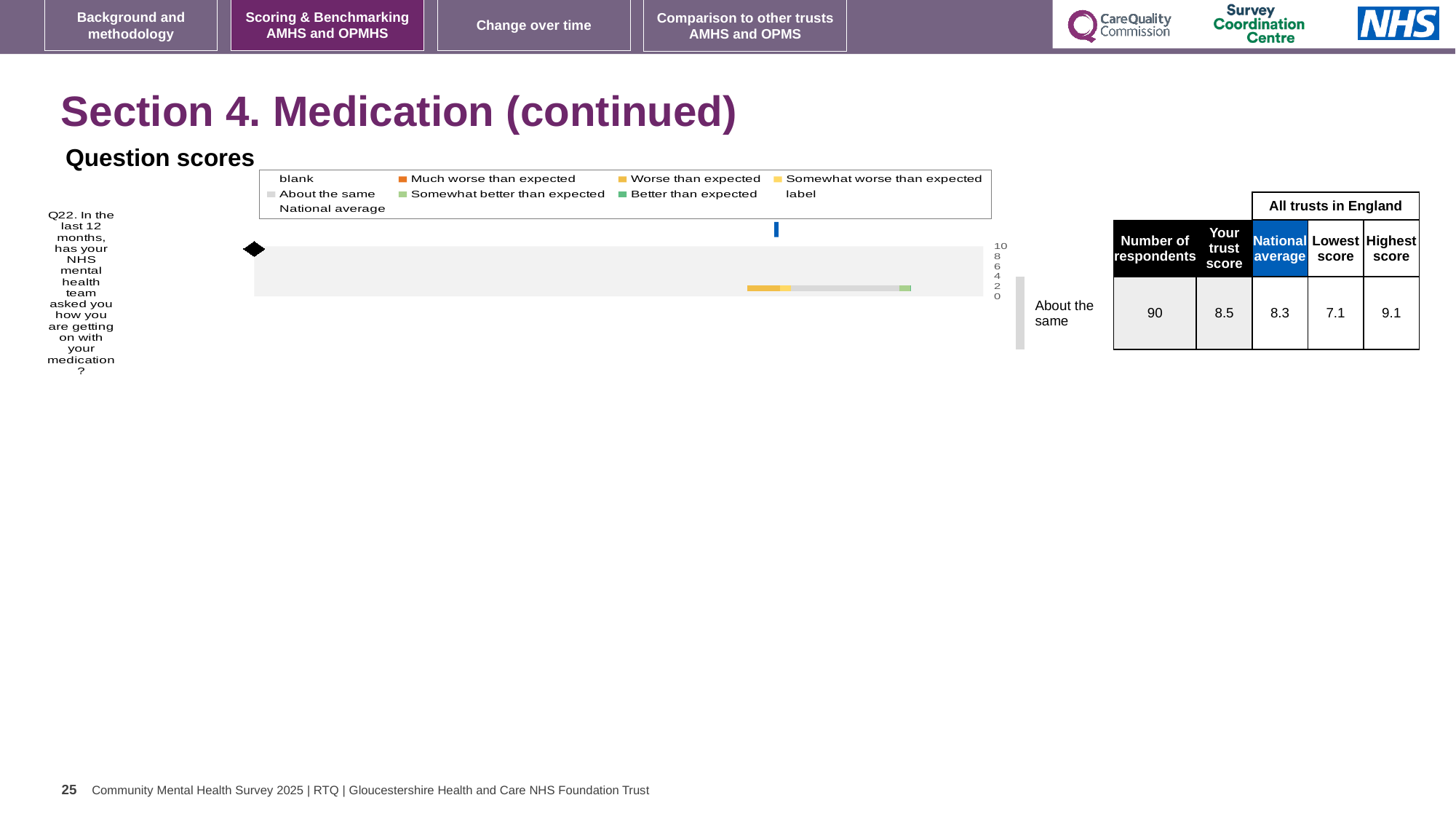
What is the highest value shown on the axis of the Question scores chart? 10 What is the difference between the highest and lowest trust scores for Q22? 2.0 What is the trust's score for Q22 shown next to the chart? 8.5 How is the trust's Q22 result categorised relative to expectation? About the same How many respondents answered Q22? 90 What is the highest score among all trusts in England for Q22? 9.1 Is the trust's score for Q22 higher or lower than the national average? higher What kind of chart is shown under 'Question scores'? bar chart What is the lowest score among all trusts in England for Q22? 7.1 Which question is plotted in the Question scores chart? Q22. In the last 12 months, has your NHS mental health team asked you how you are getting on with your medication? What is the national average score for Q22 shown next to the chart? 8.3 How many survey questions are plotted in the Question scores chart? 1